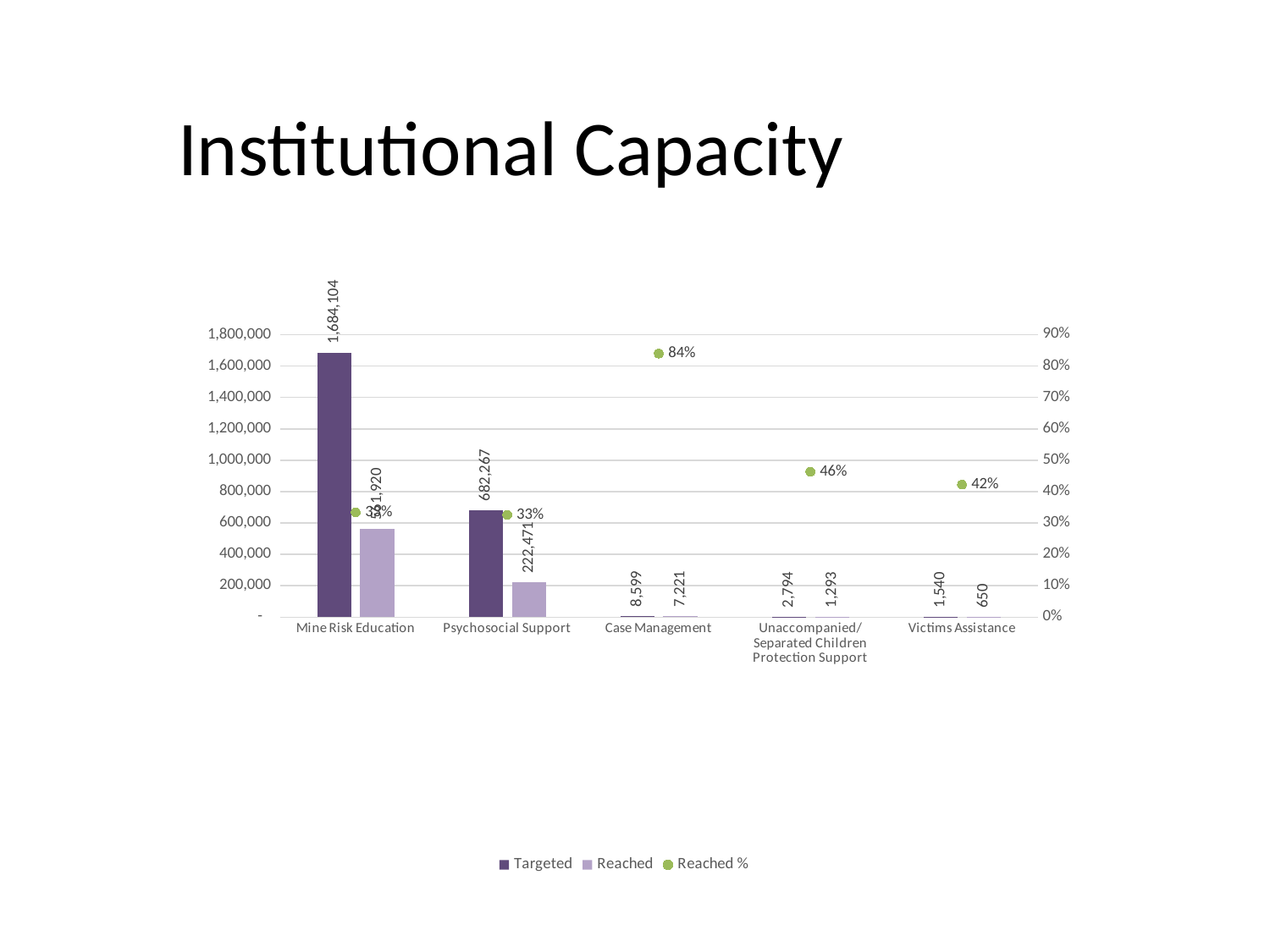
What is the Reached % for Victims Assistance? 42% Which category has the highest Reached %? Case Management What is the Targeted value for Unaccompanied/Separated Children Protection Support? 2,794 Which category has the lowest Targeted value? Victims Assistance Which has a higher Reached %, Unaccompanied/Separated Children Protection Support or Victims Assistance? Unaccompanied/Separated Children Protection Support How many series does the legend list? 3 What is the Targeted value for Psychosocial Support? 682,267 Is the Reached value for Mine Risk Education greater or less than 600,000? less What is the difference between the Targeted and Reached values for Victims Assistance? 890 What is the Reached value for Case Management? 7,221 What is the difference between the Targeted and Reached values for Case Management? 1,378 What is the Reached % for Case Management? 84%